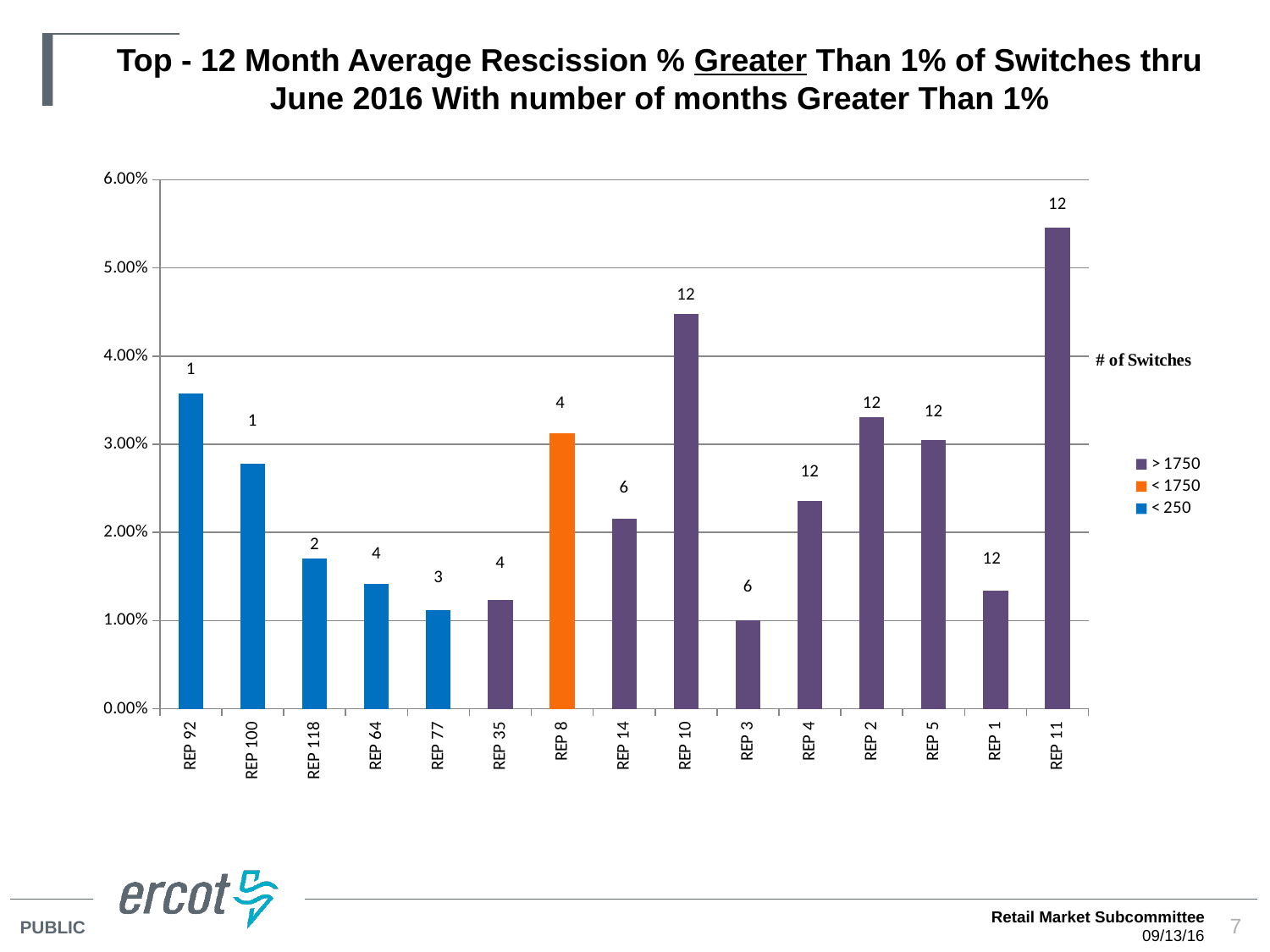
What number is labelled above the bar for REP 8? 4 What number is labelled above the bar for REP 92? 1 Which has the larger rescission %, REP 10 or REP 2? REP 10 How many entries does the legend list? 3 Is the value for REP 118 greater or less than 2.00%? less What kind of chart is shown on the slide? bar chart What number of months greater than 1% is labelled above the bar for REP 14? 6 How many REPs (categories) are plotted on the chart? 15 Which REP has the highest 12-month average rescission %? REP 11 Is the value for REP 92 greater or less than 3.00%? greater Is the value for REP 10 greater or less than 4.00%? greater Which legend category does the orange bar for REP 8 belong to? < 1750